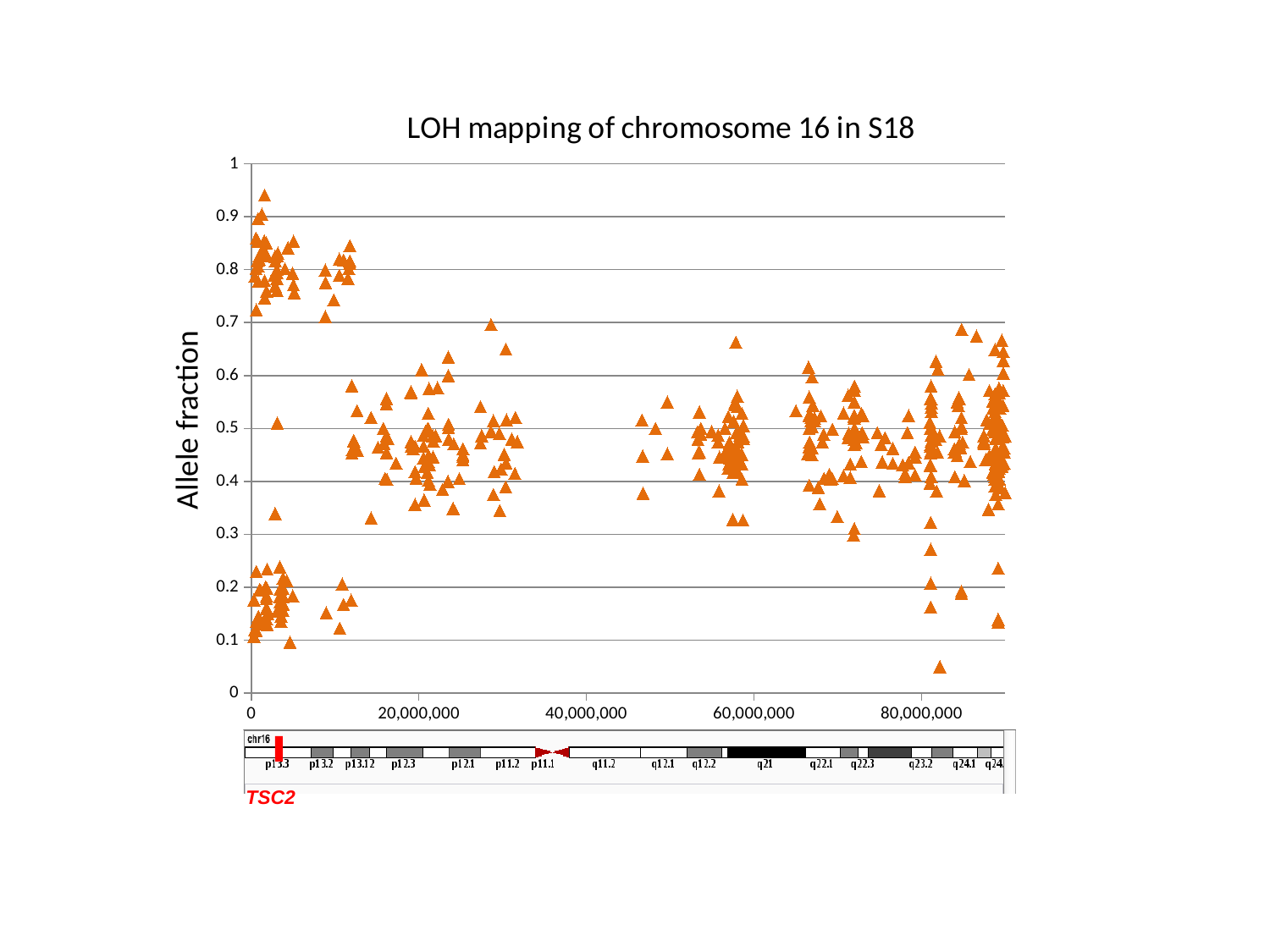
What is the label of the y axis? Allele fraction What is the maximum value shown on the y axis? 1 Is the highest plotted allele fraction between x = 40,000,000 and x = 60,000,000 greater or less than 0.7? less What is the interval between consecutive tick labels on the y axis? 0.1 What is the largest tick label shown on the x axis? 80,000,000 What is the title of the chart? LOH mapping of chromosome 16 in S18 Is the highest plotted allele fraction greater or less than 0.9? greater What kind of chart is shown on the slide? Scatter chart What gene is labelled in red below the chart? TSC2 Is the lowest plotted allele fraction greater or less than 0.1? less